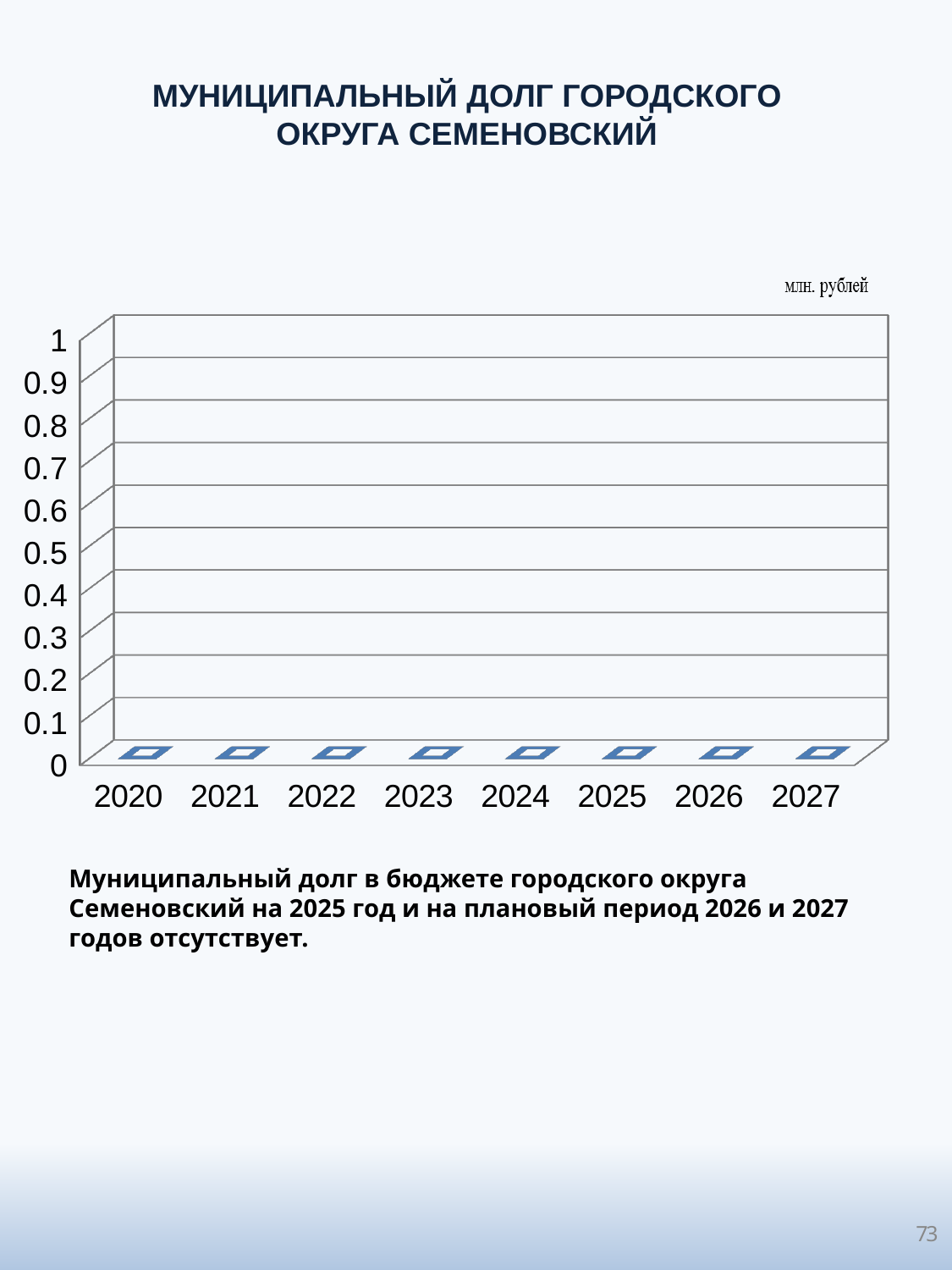
What is the last year shown on the x axis? 2027 Is the value for 2023 greater or less than 0.5? less Is the value for 2026 greater or less than 0.1? less What is the value of municipal debt for 2027? 0 How many years are shown on the x axis of the chart? 8 What is the value of municipal debt for 2025? 0 What kind of chart is shown on the slide? bar chart What is the highest value shown on the y axis? 1 What is the difference between the values for 2024 and 2021? 0 What is the value of municipal debt for 2020? 0 Do the values rise, fall or stay the same from 2020 to 2027? stay the same What is the first year shown on the x axis? 2020